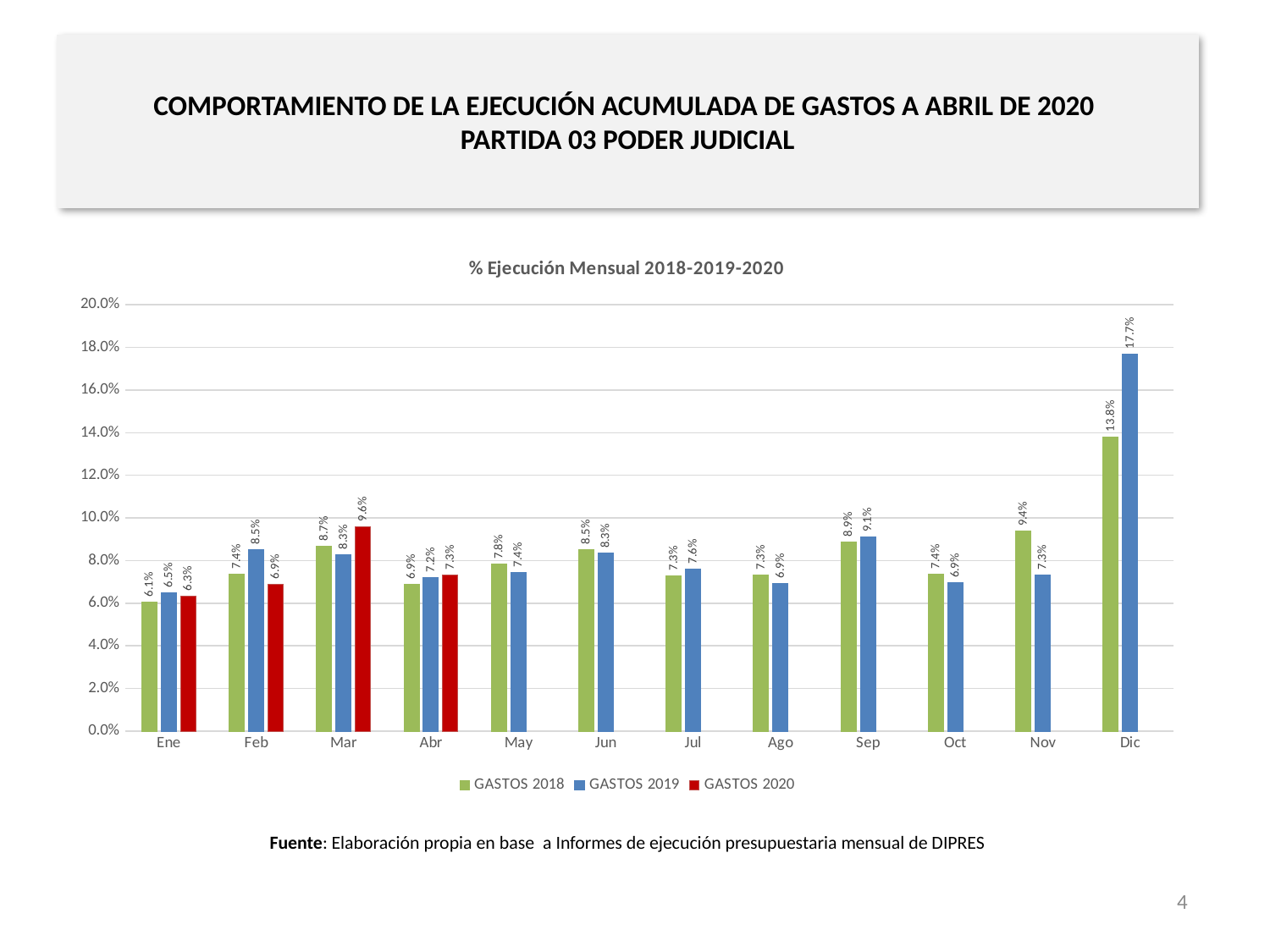
What colour are the GASTOS 2020 bars? red What type of chart is shown on the slide? bar chart What is the value for GASTOS 2019 in Dic? 17.7% Which is larger in Feb, GASTOS 2018 or GASTOS 2019? GASTOS 2019 What is the difference between GASTOS 2019 and GASTOS 2018 in Dic? 3.9% What is the value for GASTOS 2018 in Nov? 9.4% What is the value for GASTOS 2020 in Mar? 9.6% Is the value for GASTOS 2018 in Dic greater or less than 12.0%? greater How many series does the legend list? 3 In which month is GASTOS 2018 highest? Dic In which month is GASTOS 2019 lowest? Ene How many months are shown on the x axis? 12